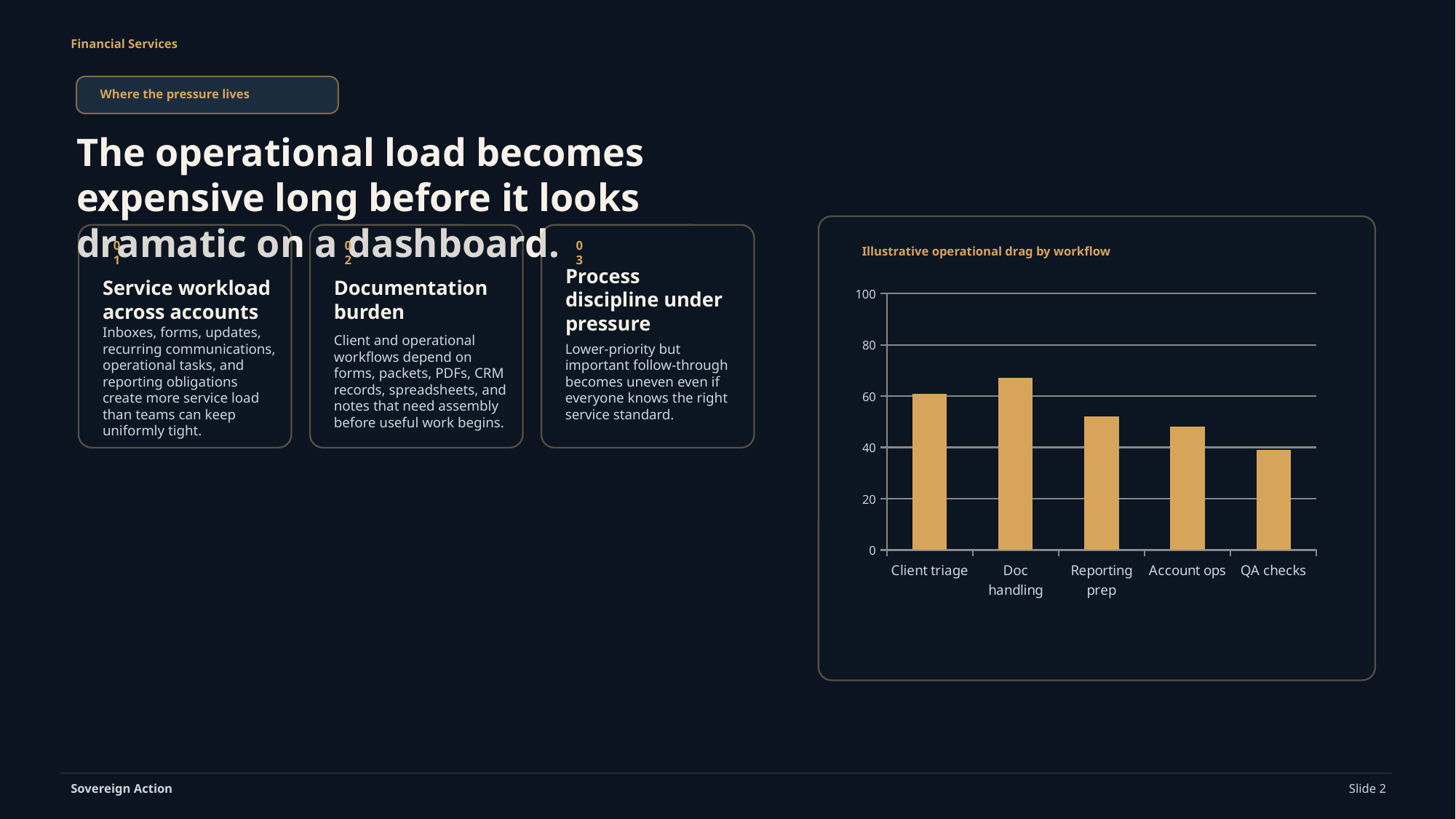
Is the value for QA checks greater or less than 60? less Is the value for Account ops greater or less than 40? greater Is the value for Doc handling greater or less than 60? greater How many workflow categories are plotted in the chart? 5 Which is larger, the value for Doc handling or the value for Reporting prep? Doc handling Which is larger, the value for Client triage or the value for QA checks? Client triage Which workflow has the lowest bar in the chart? QA checks From Doc handling through QA checks, do the bar values rise or fall along the x axis? fall Which workflow has the highest bar in the chart? Doc handling What is the title of the chart? Illustrative operational drag by workflow What kind of chart is shown on the slide? bar chart